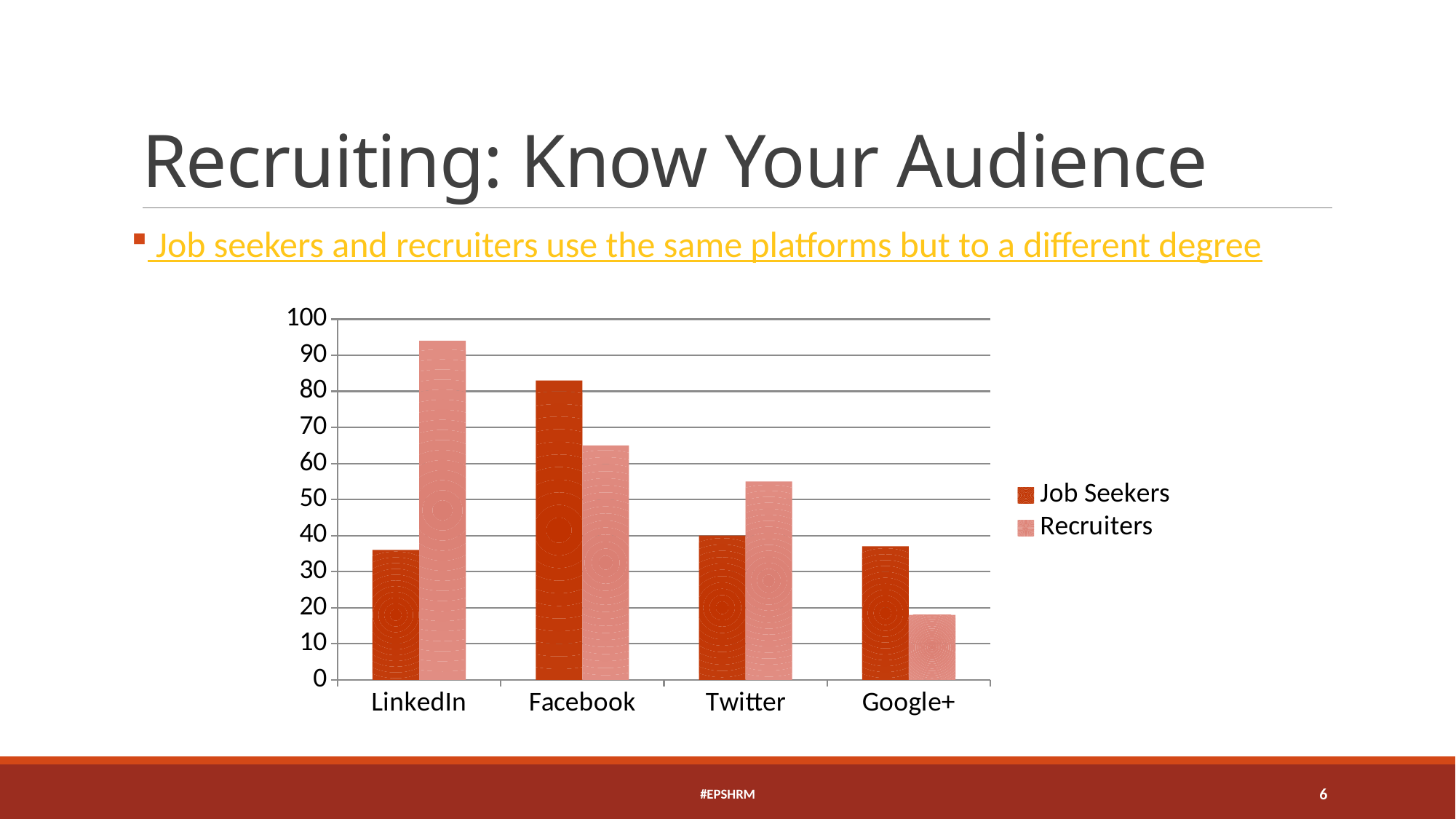
What are the two series named in the legend? Job Seekers and Recruiters Is the Job Seekers value for Google+ greater or less than 40? less Is the Recruiters value for LinkedIn greater or less than 90? greater How many platforms are shown on the x axis? 4 Which platform has the highest Recruiters value? LinkedIn Which platform has the highest Job Seekers value? Facebook Which platform has the lowest Recruiters value? Google+ For Facebook, which is larger: Job Seekers or Recruiters? Job Seekers What kind of chart is shown on the slide? bar chart For Twitter, which is larger: Job Seekers or Recruiters? Recruiters How many series does the legend list? 2 Is the Recruiters value for Google+ greater or less than 20? less